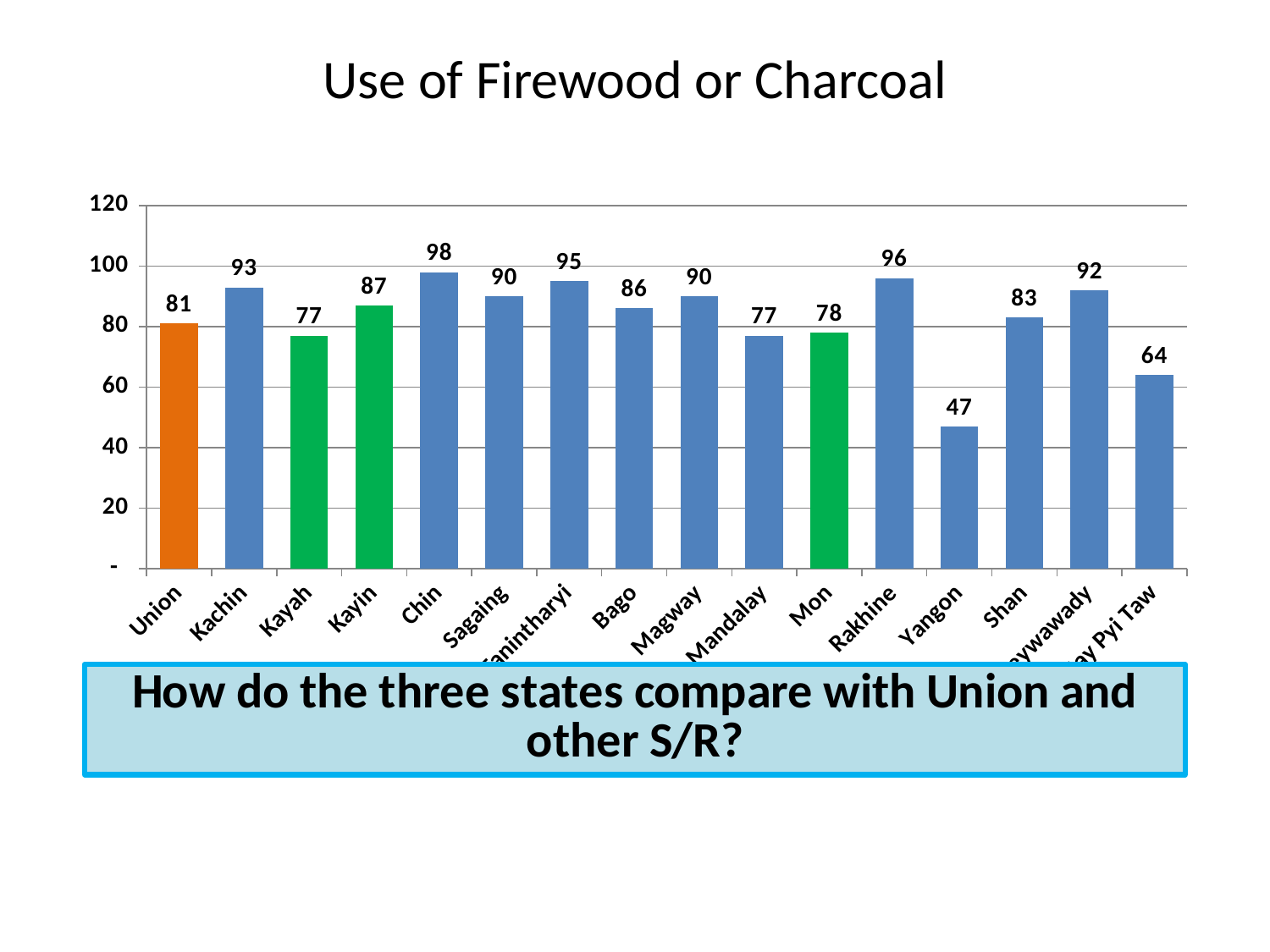
What is the difference between the values for Kachin and Kayah? 16 Which is larger, the value for Kayin or the value for Rakhine? Rakhine What kind of chart is shown on the slide? Bar chart Which category has the lowest value? Yangon Which category has the highest value? Chin What is the value for Yangon? 47 What is the value for Chin? 98 What is the value for Union? 81 What is the difference between the values for Union and Yangon? 34 How many bars are shown in the chart? 16 What is the value for Mon? 78 What colour is the bar for Union? Orange